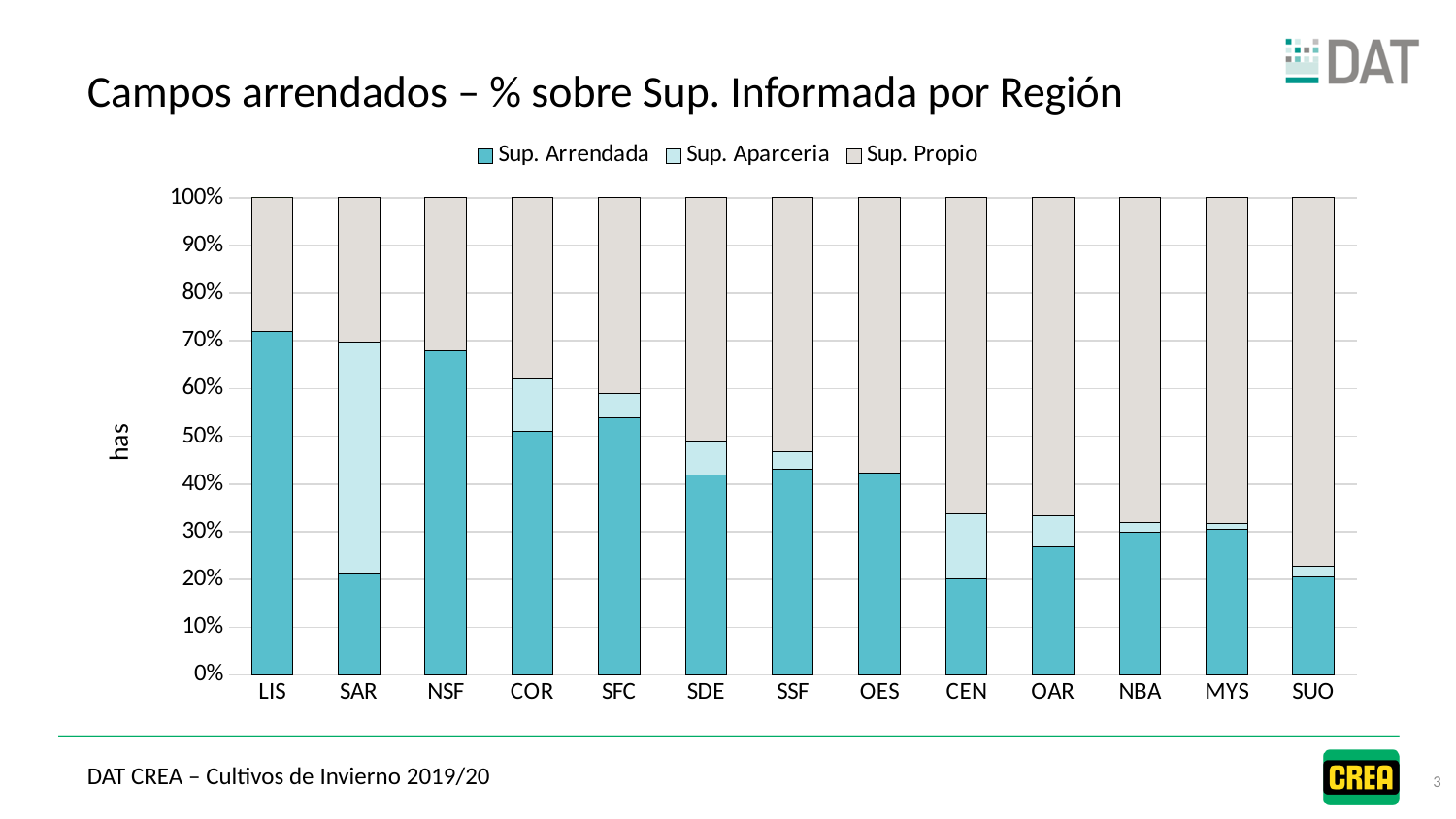
Does the Sup. Arrendada share generally rise or fall from LIS to SUO along the x axis? fall Which region has the highest Sup. Aparceria share? SAR What kind of chart is shown on the slide? Stacked bar chart Which region has a larger Sup. Arrendada share, COR or SDE? COR What label is shown on the y axis of the chart? has How many series does the chart legend list? 3 Is the Sup. Arrendada share for NSF greater or less than 60%? greater Is the Sup. Arrendada share for SAR greater or less than 30%? less Which region has the highest Sup. Propio share? SUO How many regions are shown on the x axis of the chart? 13 Which region has the highest Sup. Arrendada share? LIS What is the title of the chart on the slide? Campos arrendados – % sobre Sup. Informada por Región